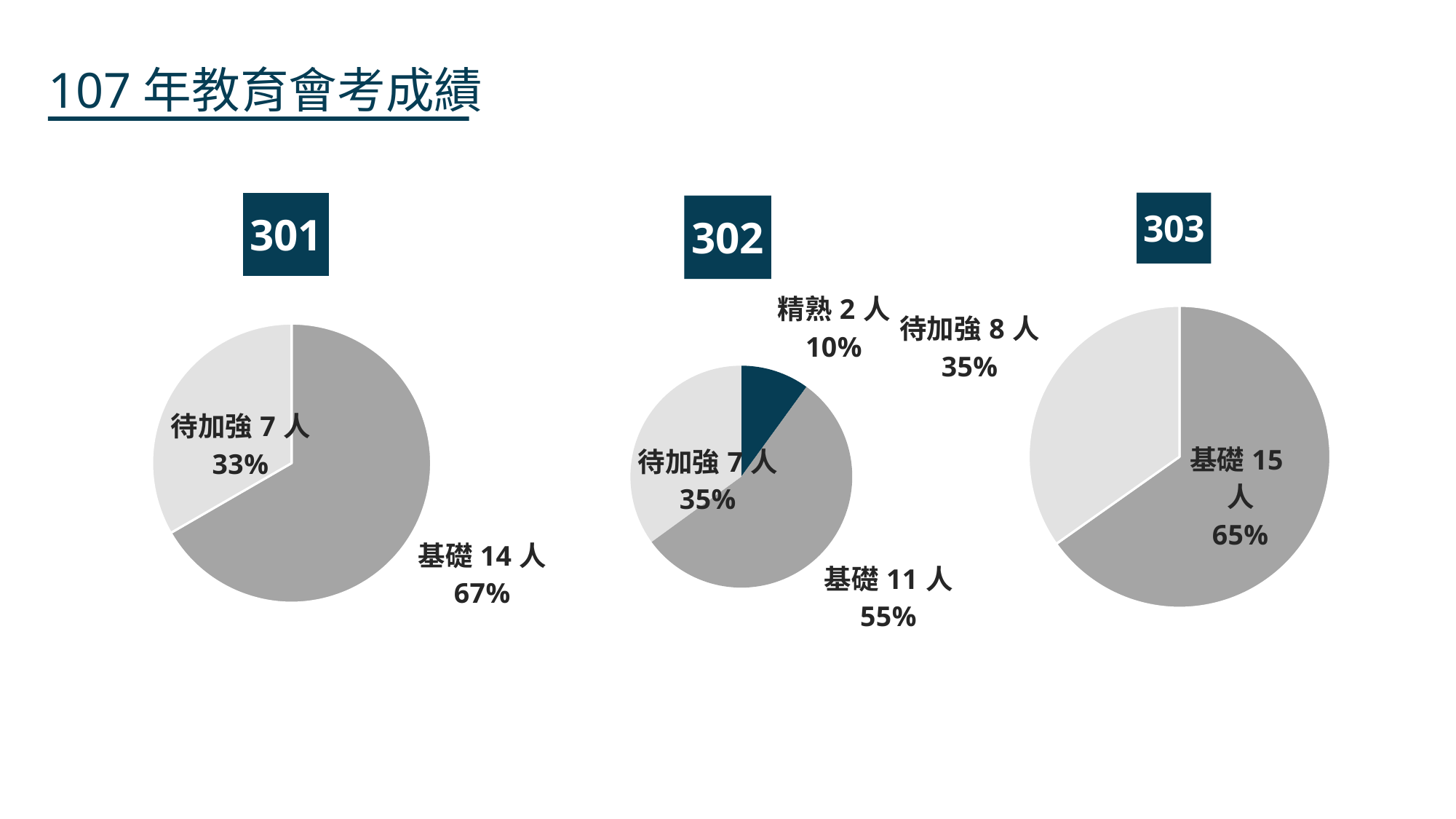
What kind of chart is used for 301, 302 and 303? Pie chart How many slices does the 302 pie chart have? 3 In the 302 pie chart, how many people are in the 精熟 category? 2 人 In the 303 pie chart, what percentage share does 基礎 have? 65% In the 301 pie chart, how many people are in the 基礎 category? 14 人 In the 303 pie chart, which category has the largest share? 基礎 In the 302 pie chart, which category has the smallest share? 精熟 In the 301 pie chart, how many more people are in 基礎 than in 待加強? 7 In the 302 pie chart, what percentage share does 基礎 have? 55% In the 301 pie chart, what percentage share does 待加強 have? 33% In the 303 pie chart, how many people are in the 待加強 category? 8 人 In the 302 pie chart, which is larger, 基礎 or 待加強? 基礎